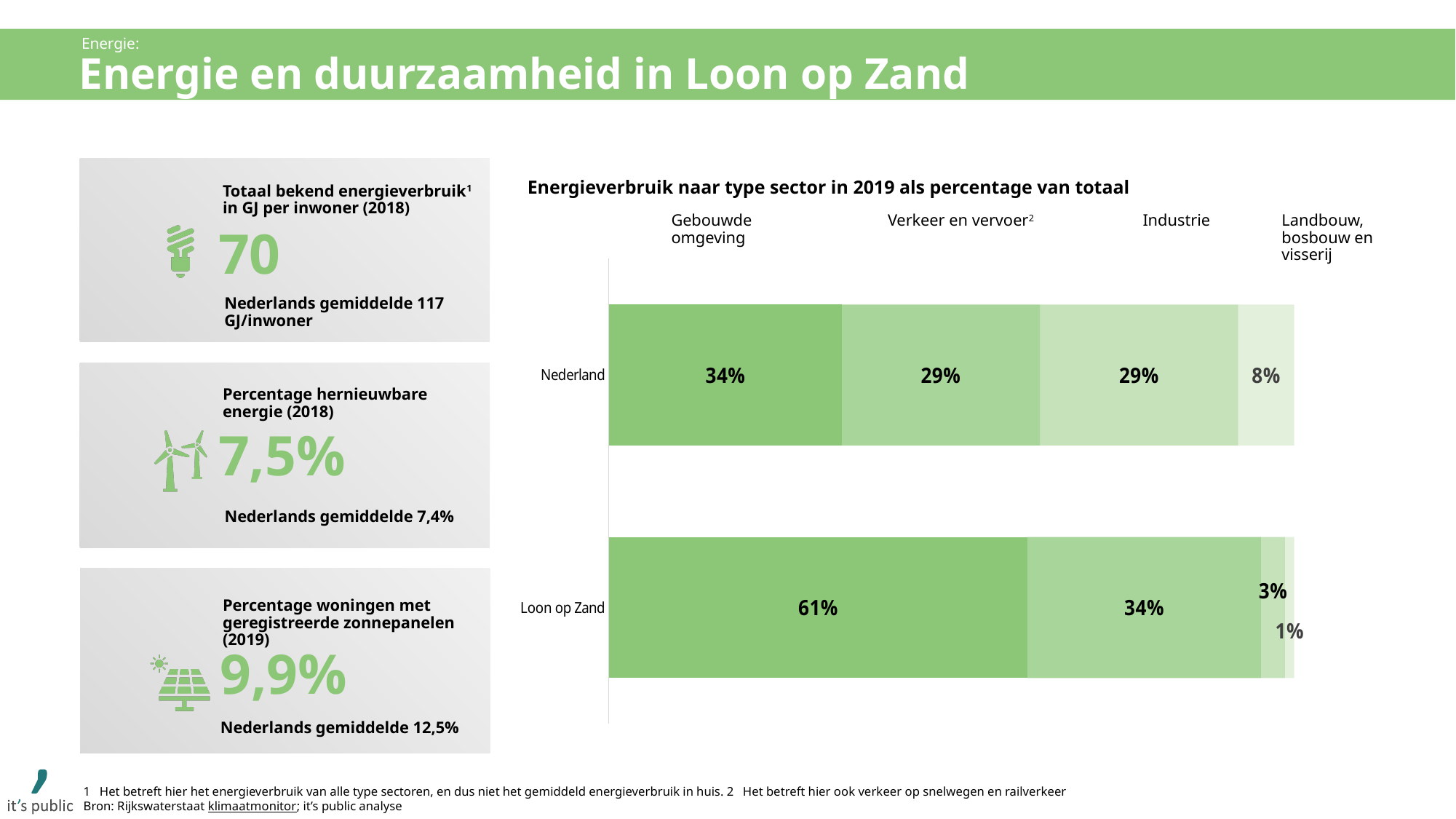
How many categories (rows) does the chart show? 2 How many sectors (series) does the chart show? 4 Which sector has the highest share for Loon op Zand? Gebouwde omgeving What is the value for Industrie for Nederland? 29% What is the difference between the Gebouwde omgeving share for Loon op Zand and for Nederland? 27 percentage points What kind of chart is shown on the slide? Stacked bar chart What is the value for Gebouwde omgeving for Loon op Zand? 61% Which is larger: the Industrie share for Nederland or for Loon op Zand? Nederland What is the value for Verkeer en vervoer for Nederland? 29% What is the value for Landbouw, bosbouw en visserij for Loon op Zand? 1% What is the title of the chart? Energieverbruik naar type sector in 2019 als percentage van totaal Which sector has the lowest share for Nederland? Landbouw, bosbouw en visserij